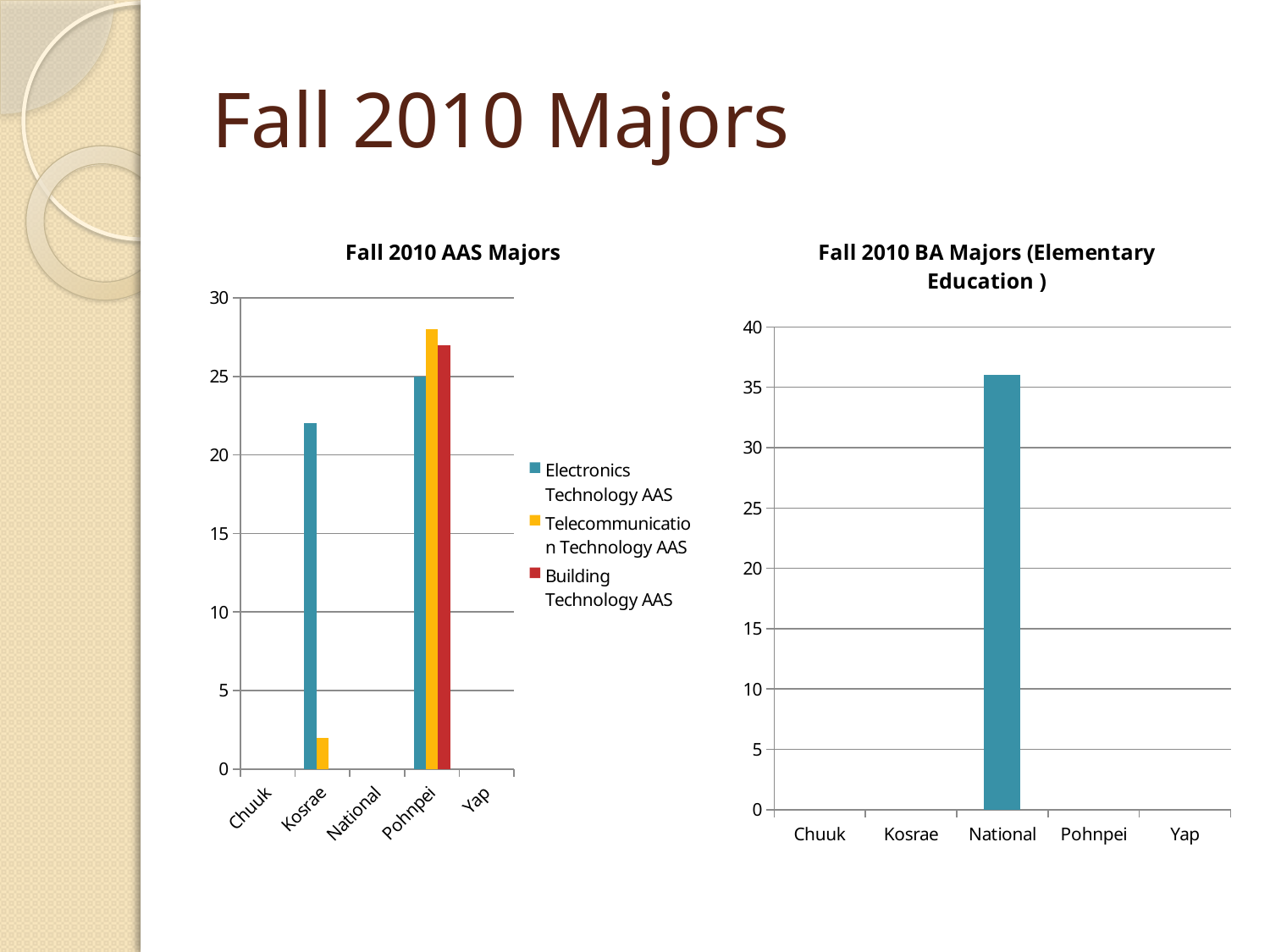
In the 'Fall 2010 AAS Majors' chart, which has the larger Electronics Technology AAS value, Kosrae or Pohnpei? Pohnpei In the 'Fall 2010 BA Majors (Elementary Education )' chart, which category has the highest value? National What kind of chart is the 'Fall 2010 AAS Majors' chart? bar chart What kind of chart is the 'Fall 2010 BA Majors (Elementary Education )' chart? bar chart In the 'Fall 2010 AAS Majors' chart, how many series does the legend list? 3 In the 'Fall 2010 AAS Majors' chart, is the Electronics Technology AAS value for Kosrae greater or less than 20? greater In the 'Fall 2010 AAS Majors' chart, which colour represents Building Technology AAS? red In the 'Fall 2010 AAS Majors' chart, how many categories are shown on the x axis? 5 In the 'Fall 2010 AAS Majors' chart, which category has the highest value for Electronics Technology AAS? Pohnpei In the 'Fall 2010 AAS Majors' chart, is the Telecommunication Technology AAS value for Kosrae greater or less than 5? less In the 'Fall 2010 BA Majors (Elementary Education )' chart, is the value for National greater or less than 35? greater In the 'Fall 2010 BA Majors (Elementary Education )' chart, how many categories are shown on the x axis? 5